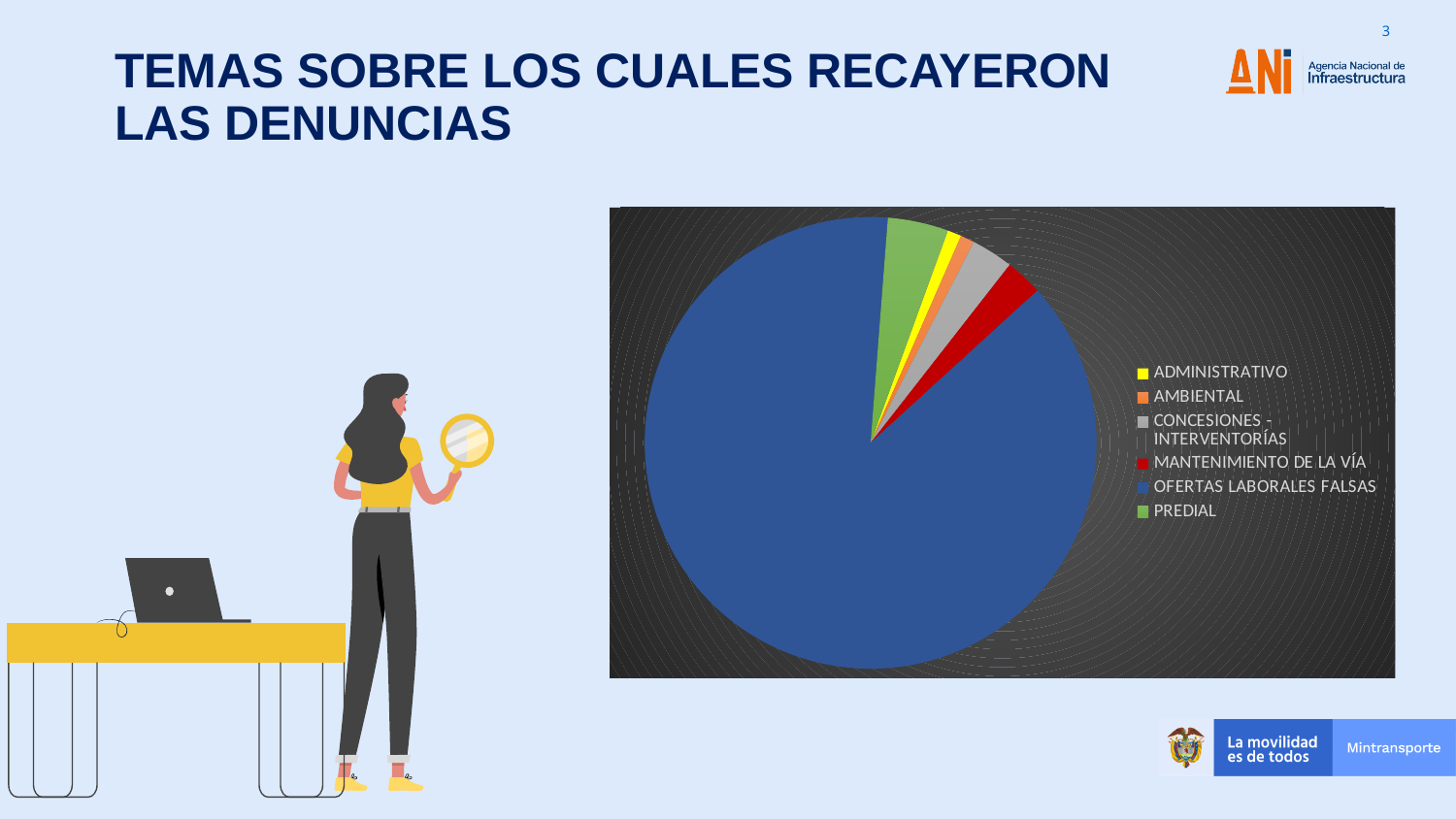
What colour is the OFERTAS LABORALES FALSAS slice in the pie chart? blue What kind of chart is shown on the slide? pie chart Which slice is larger, PREDIAL or ADMINISTRATIVO? PREDIAL Which slice is larger, MANTENIMIENTO DE LA VÍA or AMBIENTAL? MANTENIMIENTO DE LA VÍA Which slice is larger, OFERTAS LABORALES FALSAS or PREDIAL? OFERTAS LABORALES FALSAS Which category has the largest slice of the pie chart? OFERTAS LABORALES FALSAS How many categories does the pie chart's legend list? 6 Which legend entry is shown in green? PREDIAL